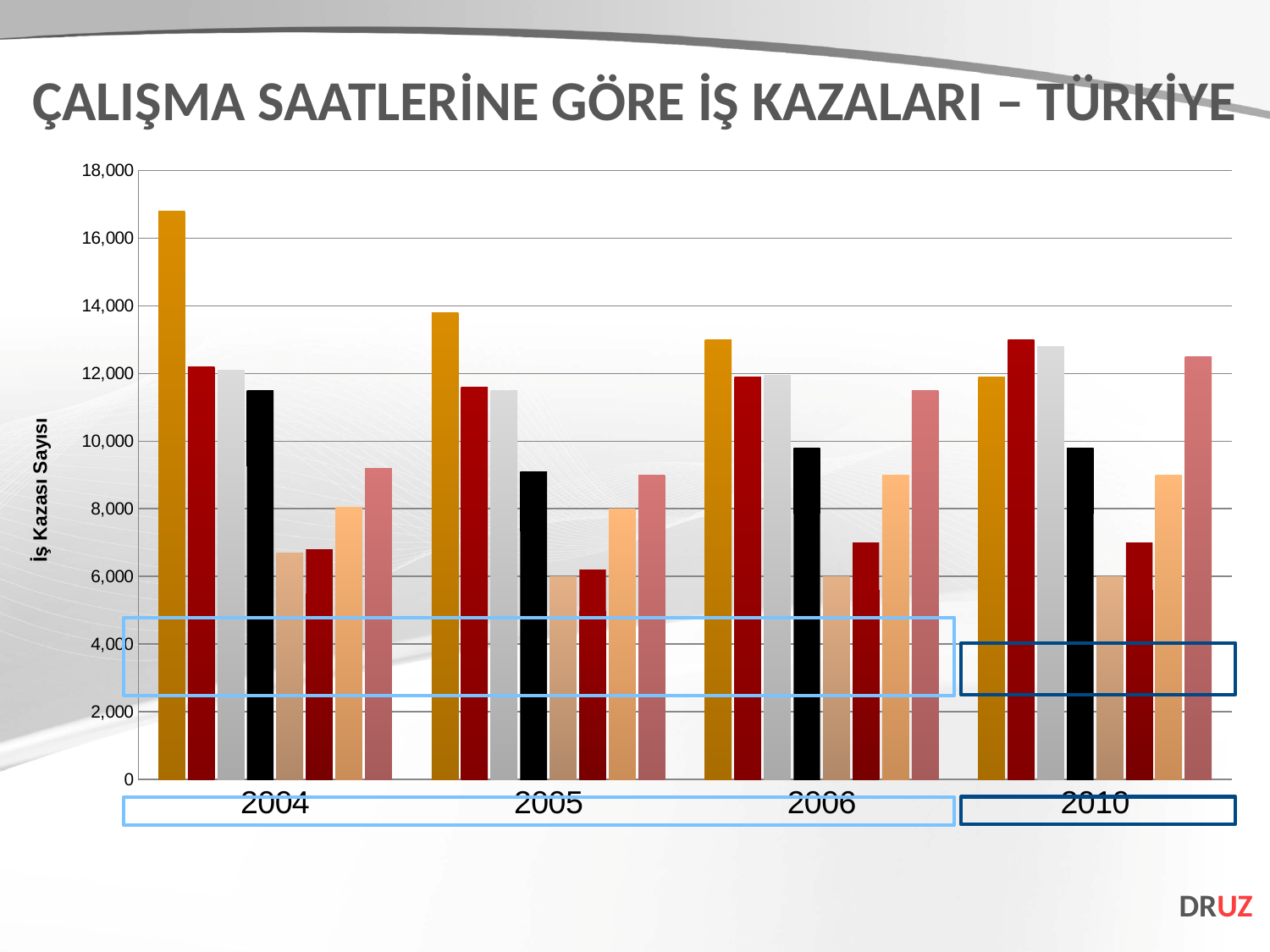
Is the value of the tallest bar in the 2004 group greater or less than 16,000? greater Does the first (orange) bar in each group rise or fall from 2004 to 2010? fall Is the value of the black bar in the 2005 group greater or less than 10,000? less What kind of chart is shown on the slide? bar chart What is the title of the chart on the slide? ÇALIŞMA SAATLERİNE GÖRE İŞ KAZALARI – TÜRKİYE What is the label of the vertical axis of the chart? İş Kazası Sayısı Is the value of the black bar in the 2004 group greater or less than 10,000? greater Which is larger: the first (orange) bar in 2004 or the first (orange) bar in 2010? 2004 How many bars are plotted for each year in the chart? 8 Which year group contains the tallest bar in the chart? 2004 How many year categories are shown on the x axis of the chart? 4